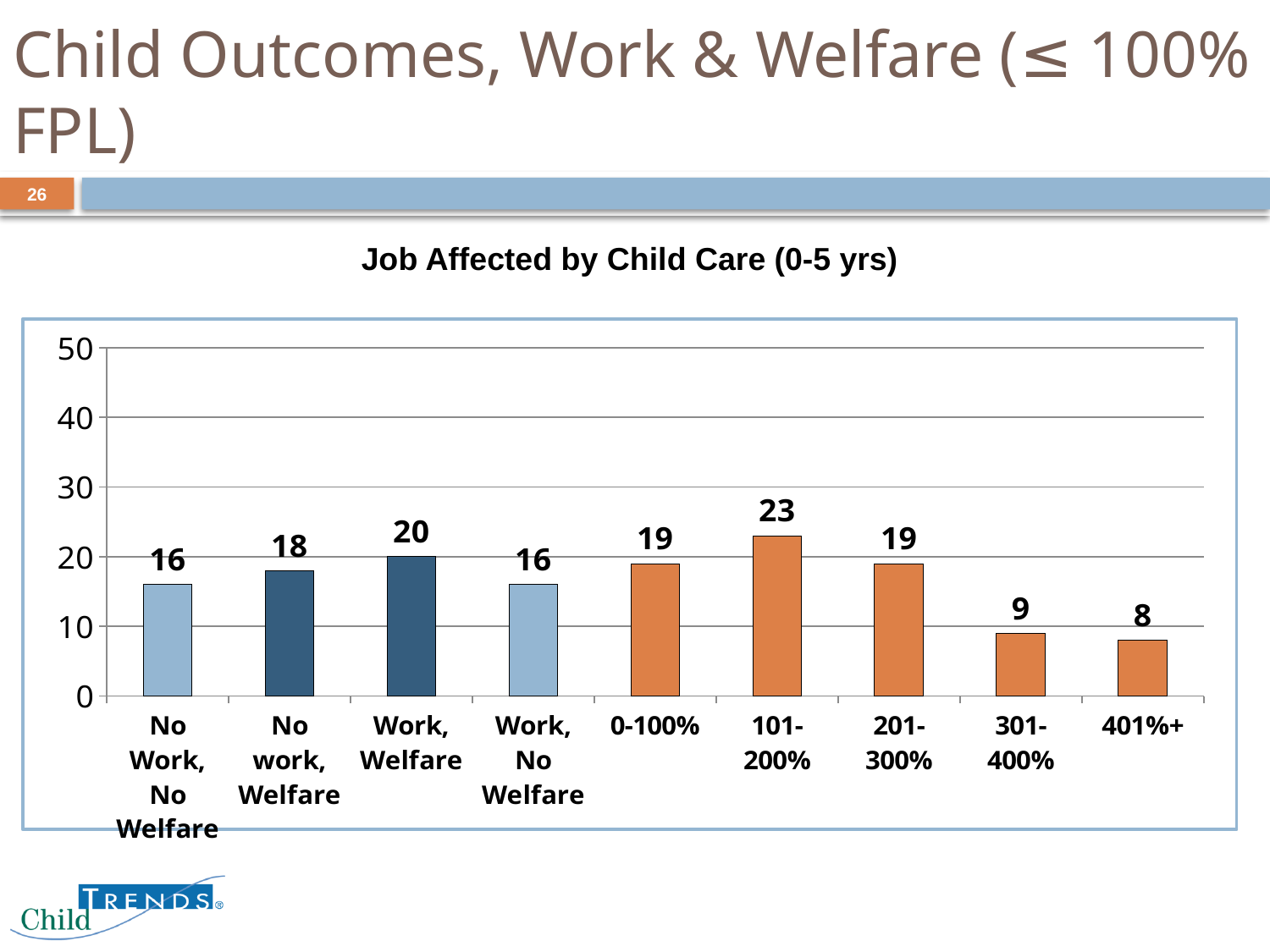
What is the value for the 101-200% category? 23 Is the value for 201-300% greater or less than 10? greater What is the title of the chart? Job Affected by Child Care (0-5 yrs) What kind of chart is shown? bar chart How many categories are shown on the x axis? 9 What is the highest value shown on the y axis? 50 Which is larger, the value for No work, Welfare or the value for Work, No Welfare? No work, Welfare Which category has the highest value? 101-200% Which category has the lowest value? 401%+ What is the difference between the values for 101-200% and 301-400%? 14 What is the value for the Work, Welfare category? 20 What is the value for the 401%+ category? 8